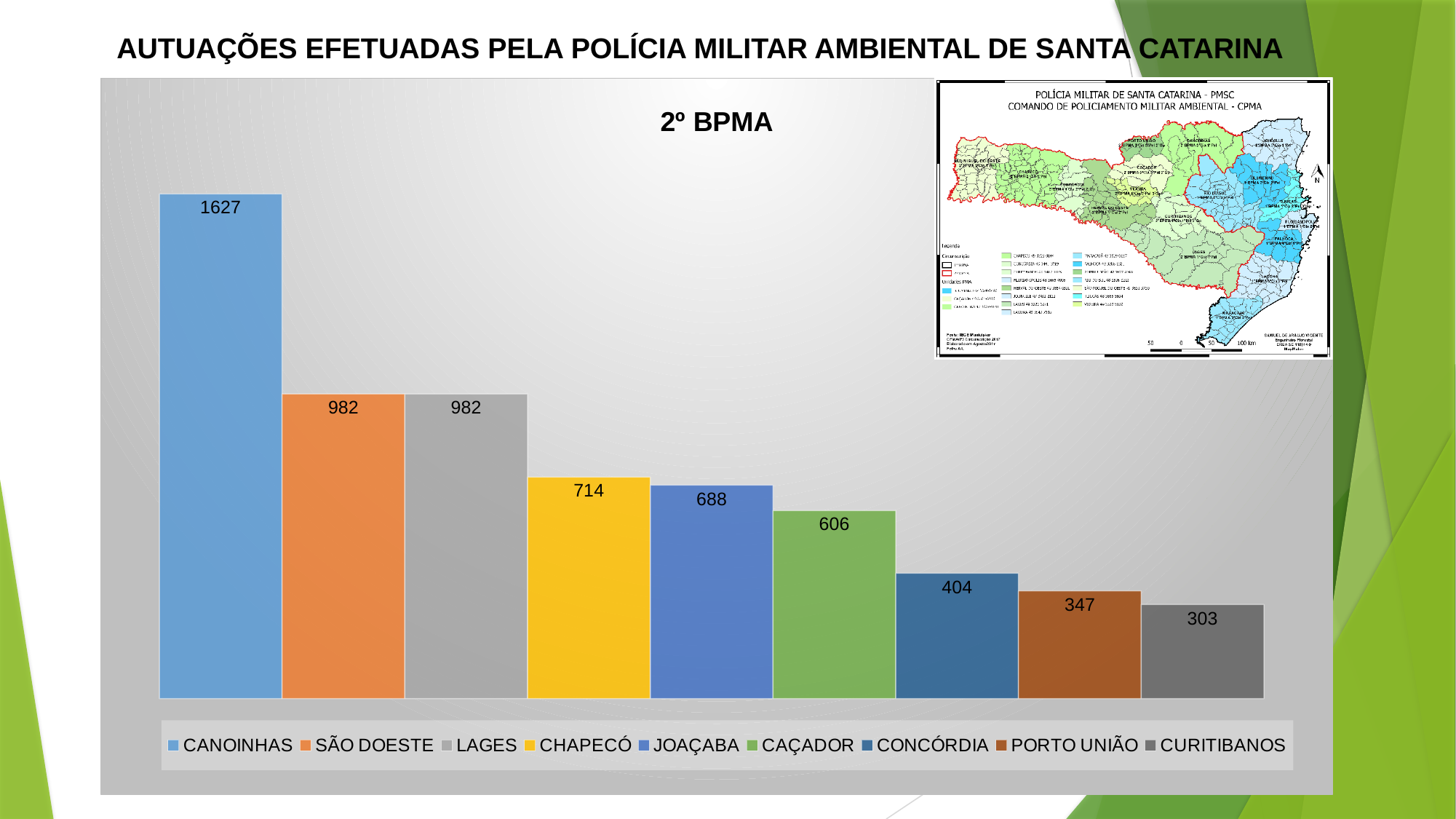
Which category has the highest value? CANOINHAS How many categories are shown in the chart? 9 Which category has the lowest value? CURITIBANOS What is the title of the chart? 2º BPMA What is the difference between the values for JOAÇABA and CAÇADOR? 82 What is the value for CANOINHAS? 1627 What is the value for CURITIBANOS? 303 What is the value for CHAPECÓ? 714 Which is larger, the value for PORTO UNIÃO or the value for CONCÓRDIA? CONCÓRDIA What is the difference between the values for CANOINHAS and LAGES? 645 What is the value for CONCÓRDIA? 404 What kind of chart is shown on the slide? Bar chart